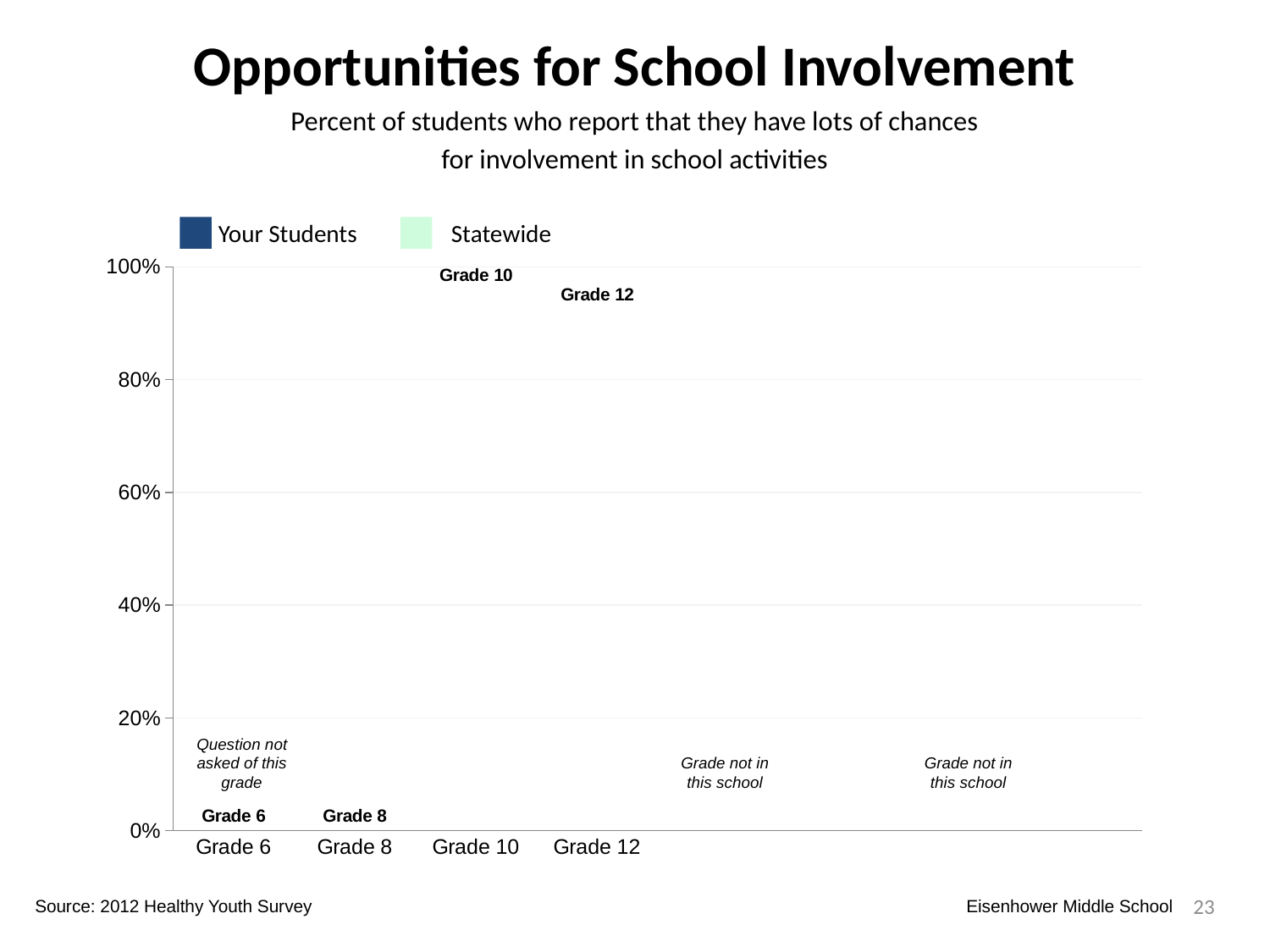
What is the lowest value shown on the y axis? 0% What is the title of the chart? Opportunities for School Involvement How many series does the legend list? 2 What is the highest value shown on the y axis? 100% How many grade categories are shown on the x axis? 4 Which series is shown in dark blue in the legend? Your Students